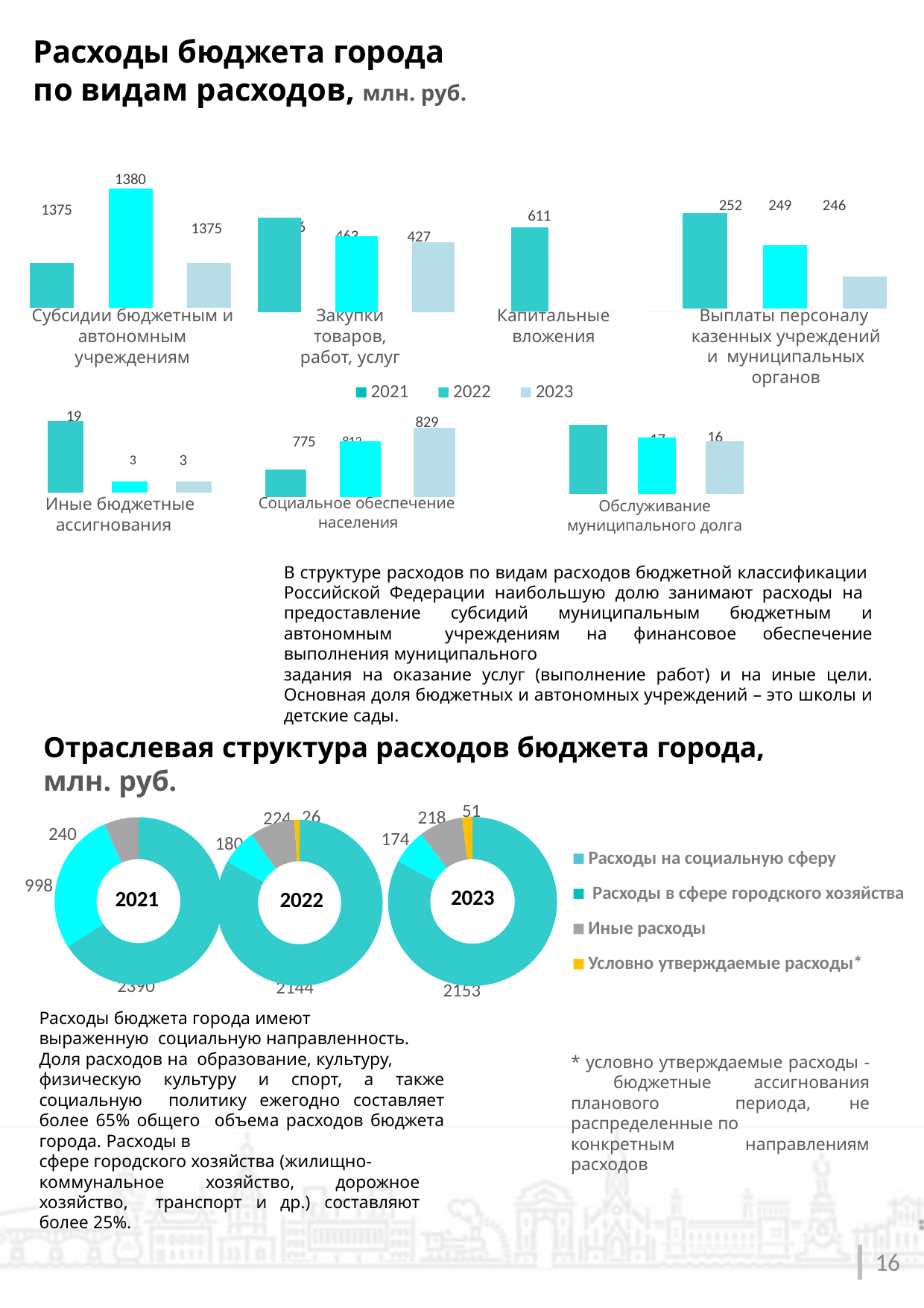
How many donut charts are shown under 'Отраслевая структура расходов бюджета города'? 3 In the top bar chart, which is larger for 'Закупки товаров, работ, услуг': the 2022 value or the 2023 value? 2022 In the top bar chart, what is the 2021 value for 'Иные бюджетные ассигнования'? 19 How many series does the legend of the top bar chart list? 3 In the top bar chart, what is the difference between the 2021 and 2023 values for 'Выплаты персоналу казенных учреждений и муниципальных органов'? 6 In the 'Отраслевая структура расходов бюджета города' donut charts, what is the largest value shown for 2021? 2390 What kind of chart is the top chart 'Расходы бюджета города по видам расходов'? bar chart In the top bar chart, what is the 2021 value for 'Выплаты персоналу казенных учреждений и муниципальных органов'? 252 In the top bar chart, do the values for 'Выплаты персоналу казенных учреждений и муниципальных органов' rise or fall from 2021 to 2023? fall In the top bar chart, what is the 2021 value for 'Капитальные вложения'? 611 In the top bar chart, what is the 2023 value for 'Социальное обеспечение населения'? 829 In the top bar chart 'Расходы бюджета города по видам расходов', what is the 2022 value for 'Субсидии бюджетным и автономным учреждениям'? 1380